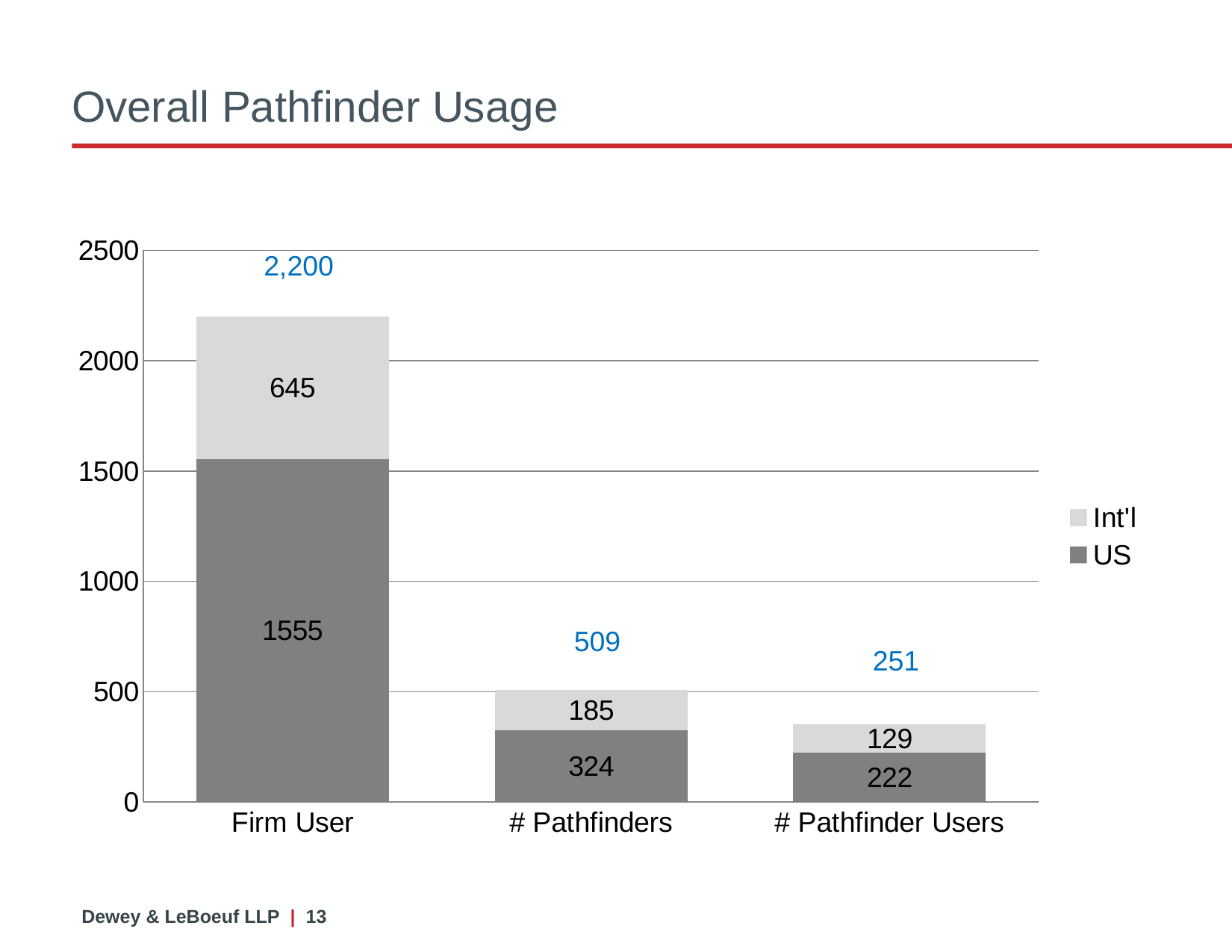
What is the US value for # Pathfinder Users? 222 Which is larger for # Pathfinders, the US value or the Int'l value? US What kind of chart is shown on the slide? Stacked bar chart What is the Int'l value for # Pathfinders? 185 How many series does the legend list? 2 Which category has the highest US value? Firm User What is the total of the stacked bar for Firm User? 2,200 What is the Int'l value for Firm User? 645 What is the difference between the US value and the Int'l value for Firm User? 910 How many categories are shown on the x axis? 3 What is the US value for Firm User? 1555 Which category has the lowest Int'l value? # Pathfinder Users